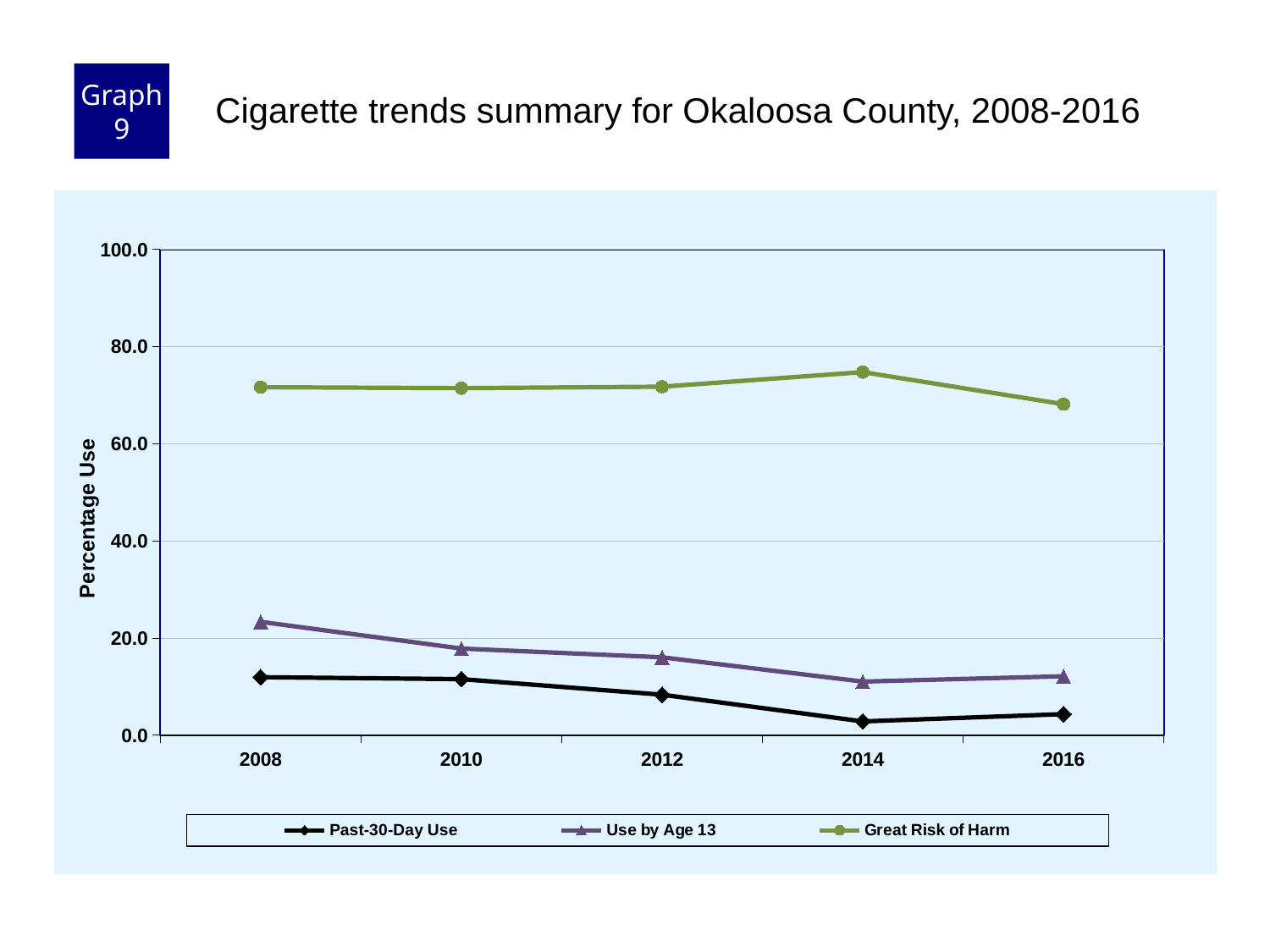
How many years are plotted along the x axis? 5 Is the Past-30-Day Use value for 2014 greater or less than 20.0? less In which year is the Great Risk of Harm value lowest? 2016 Does Past-30-Day Use rise or fall from 2008 to 2014? Fall What kind of chart is shown on the slide? Line chart Is the Great Risk of Harm value for 2014 greater or less than 80.0? less In which year is the Great Risk of Harm value highest? 2014 How many series does the legend list? 3 Is the Use by Age 13 value for 2008 greater or less than 20.0? greater Which series has the highest values across all years? Great Risk of Harm What is the label on the y axis? Percentage Use In which year is the Use by Age 13 value highest? 2008